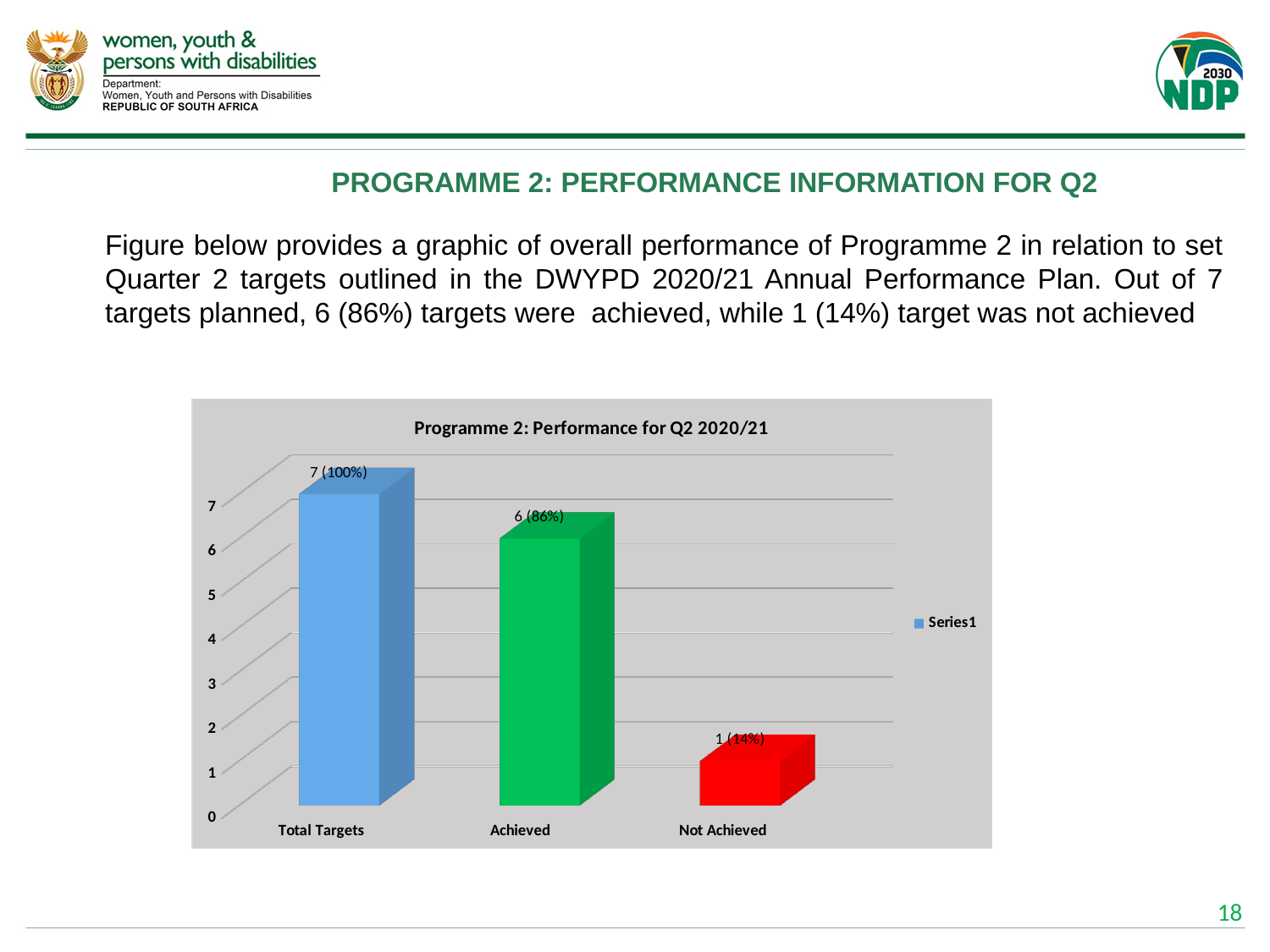
Is the value for Achieved greater or less than 5? greater What is the value shown for Not Achieved? 1 (14%) What is the value shown for Total Targets? 7 (100%) Which category has the highest value? Total Targets How many series does the legend list? 1 How many categories are shown on the x axis? 3 What is the difference between the Achieved and Not Achieved values? 5 What is the value shown for Achieved? 6 (86%) What is the title of the chart? Programme 2: Performance for Q2 2020/21 What kind of chart is shown on the slide? Bar chart Which category has the lowest value? Not Achieved Which is larger, the value for Achieved or the value for Not Achieved? Achieved